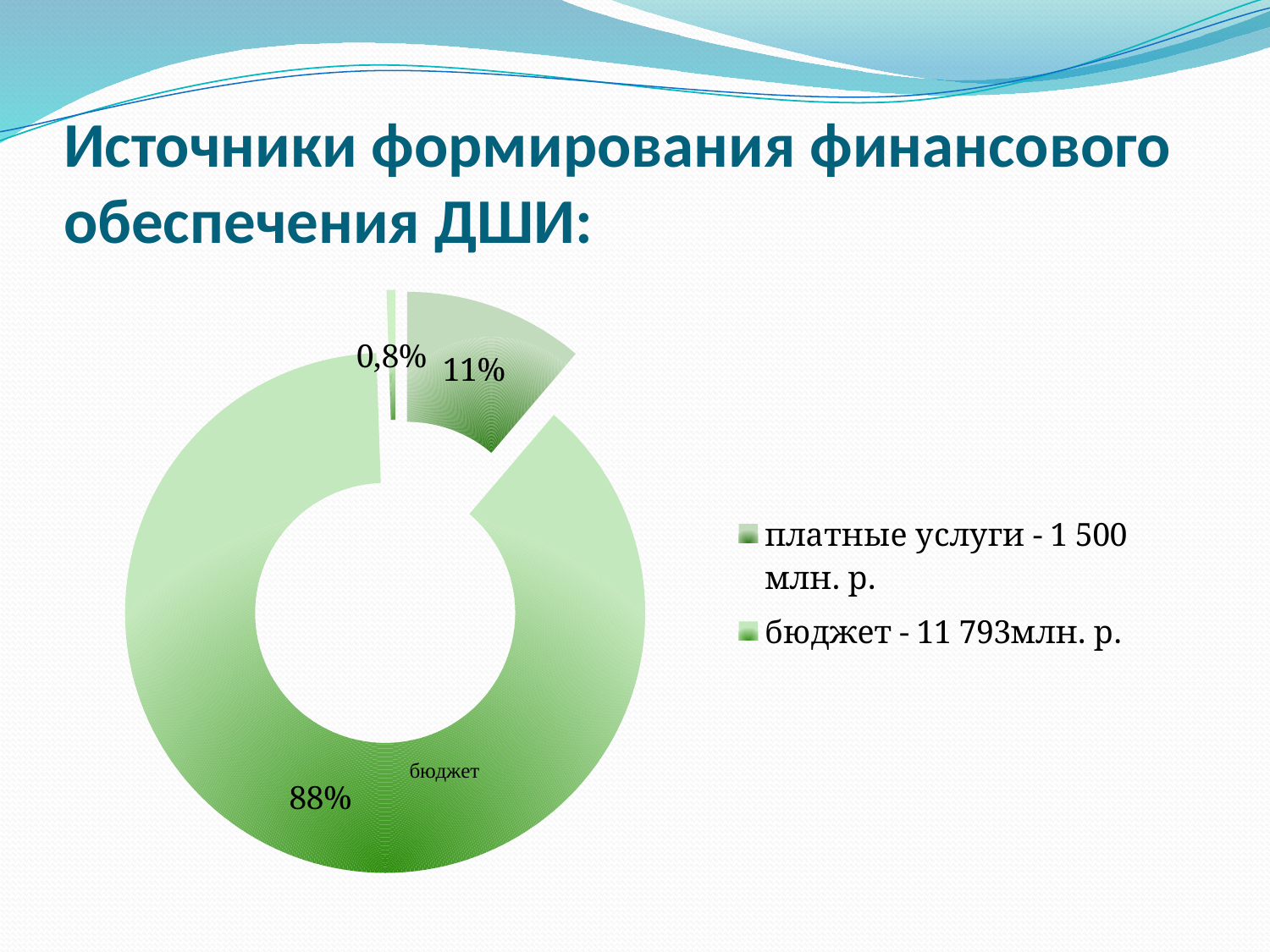
What kind of chart is shown on the slide? doughnut (pie) chart What share of the chart does the бюджет slice represent? 88% What is the smallest percentage label shown on the chart? 0,8% According to the legend, what amount is given for бюджет? 11 793млн. р. According to the legend, what amount is given for платные услуги? 1 500 млн. р. Which is larger, the бюджет slice or the платные услуги slice? бюджет What share of the chart does the платные услуги slice represent? 11% Which slice of the chart is the largest? бюджет What is the difference in percentage points between the бюджет slice (88%) and the платные услуги slice (11%)? 77% How many slices are labelled with percentages on the chart? 3 What is the title of the slide containing the chart? Источники формирования финансового обеспечения ДШИ: How many entries does the chart legend list? 2